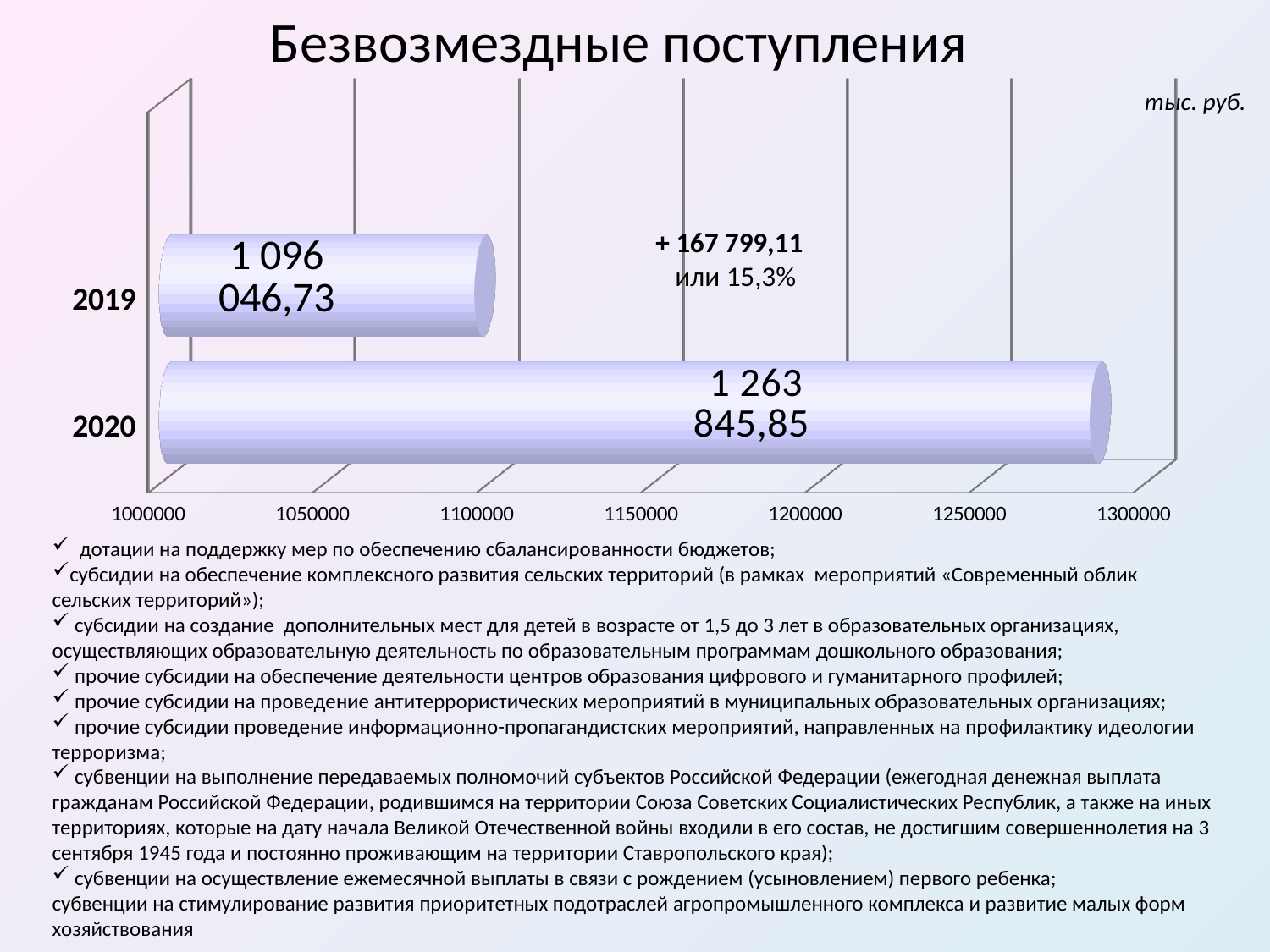
What is the difference between the 2020 and 2019 values? 167 799,11 What is the value for 2019? 1 096 046,73 What is the title of the chart? Безвозмездные поступления Which year has the higher value? 2020 Is the value for 2019 greater or less than 1100000? less What kind of chart is shown on the slide? Bar chart In what units are the chart values given? тыс. руб. What is the value for 2020? 1 263 845,85 How many years are shown in the chart? 2 Is the value for 2020 greater or less than 1250000? greater Is the value for 2020 larger than the value for 2019? Yes Which year has the lower value? 2019